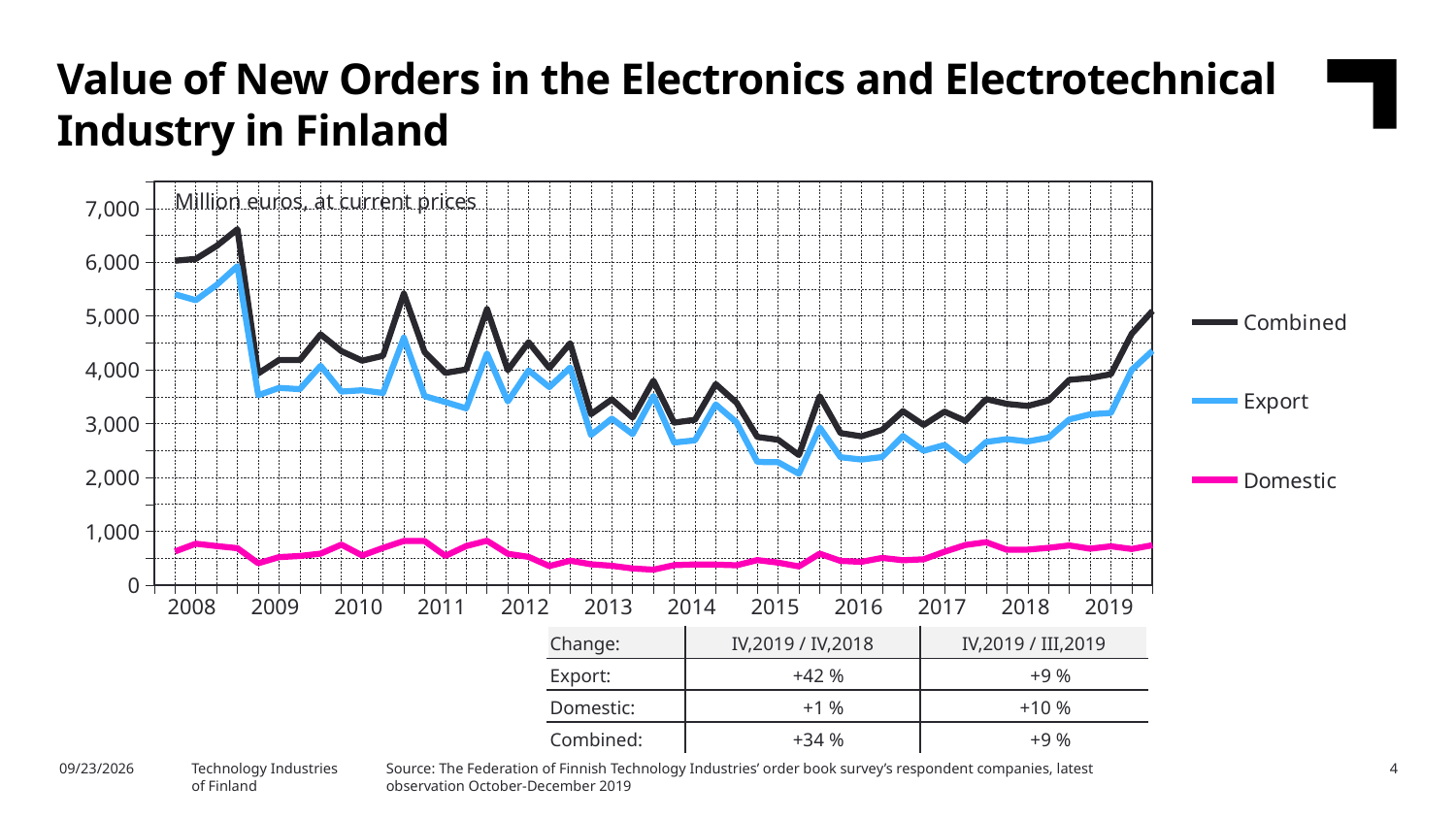
Does the Combined series rise or fall from 2008 to 2015? Fall Is the peak value for Combined in 2008 greater or less than 6,000? greater How many year labels are shown on the x axis? 12 What kind of chart is shown on the slide? Line chart Which series has the lowest values throughout the chart? Domestic Is the lowest value for Combined around 2015 greater or less than 3,000? less Which series has the highest values throughout the chart? Combined Which is larger in 2019, the Export value or the Domestic value? Export What unit is stated at the top of the chart? Million euros, at current prices Is the value for Export at the end of 2019 greater or less than 4,000? greater How many series does the legend list? 3